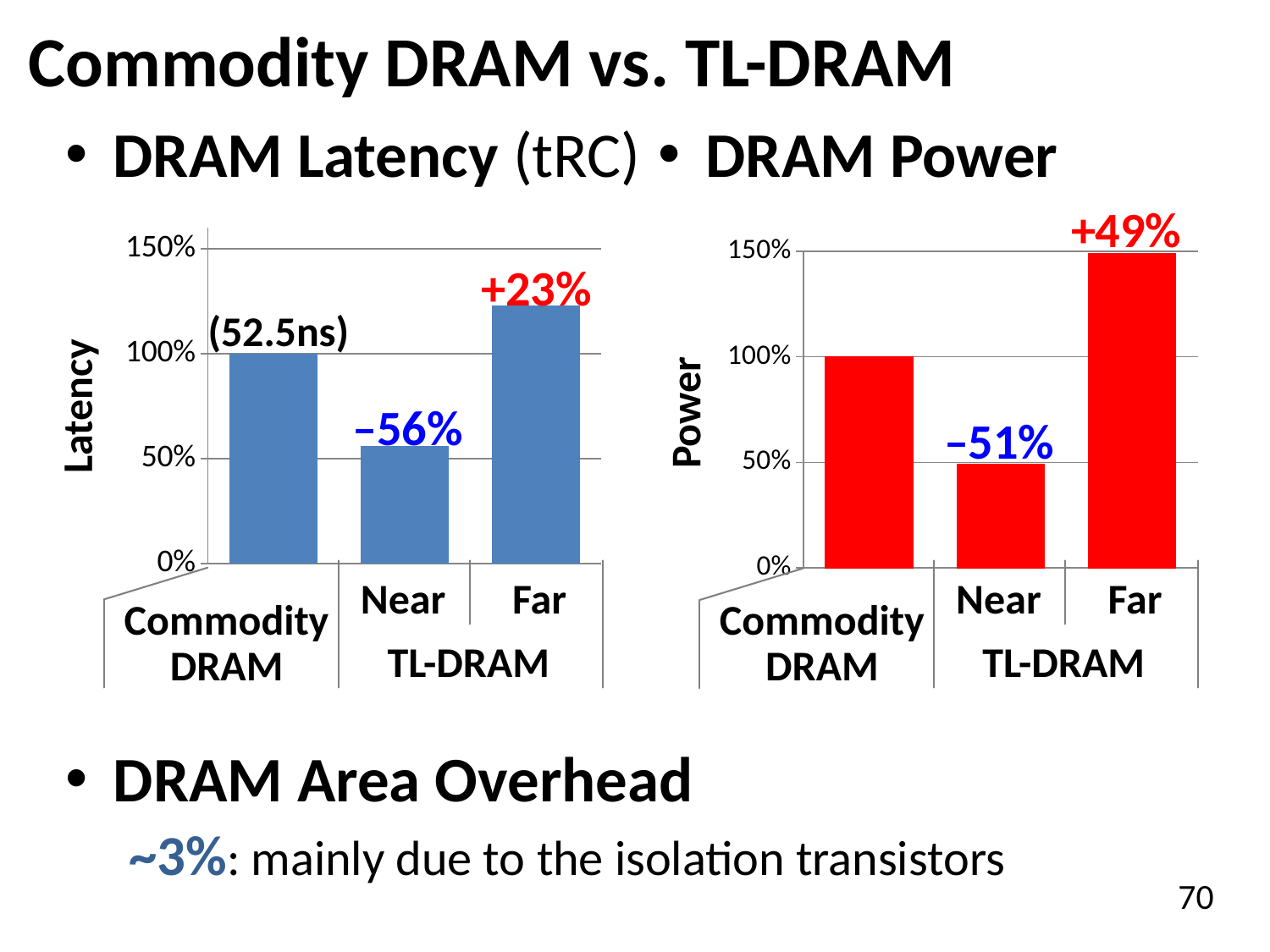
What type of chart is used for DRAM Power? bar chart What colour are the bars in the DRAM Power chart? red How many bars are plotted in the DRAM Latency chart? 3 In the DRAM Power chart, which bar is the highest? TL-DRAM Far In the DRAM Power chart, what percentage change is labeled above the TL-DRAM Far bar? +49% In the DRAM Latency chart, which bar is the lowest? TL-DRAM Near In the DRAM Power chart, what percentage change is labeled above the TL-DRAM Near bar? –51% In the DRAM Power chart, is the value for TL-DRAM Far greater or less than 100%? greater In the DRAM Latency chart, what percentage change is labeled above the TL-DRAM Near bar? –56% In the DRAM Latency chart, what value does the Commodity DRAM bar reach on the y axis? 100% In the DRAM Latency chart, what percentage change is labeled above the TL-DRAM Far bar? +23% In the DRAM Latency chart, what absolute latency value is shown in parentheses above the Commodity DRAM bar? (52.5ns)